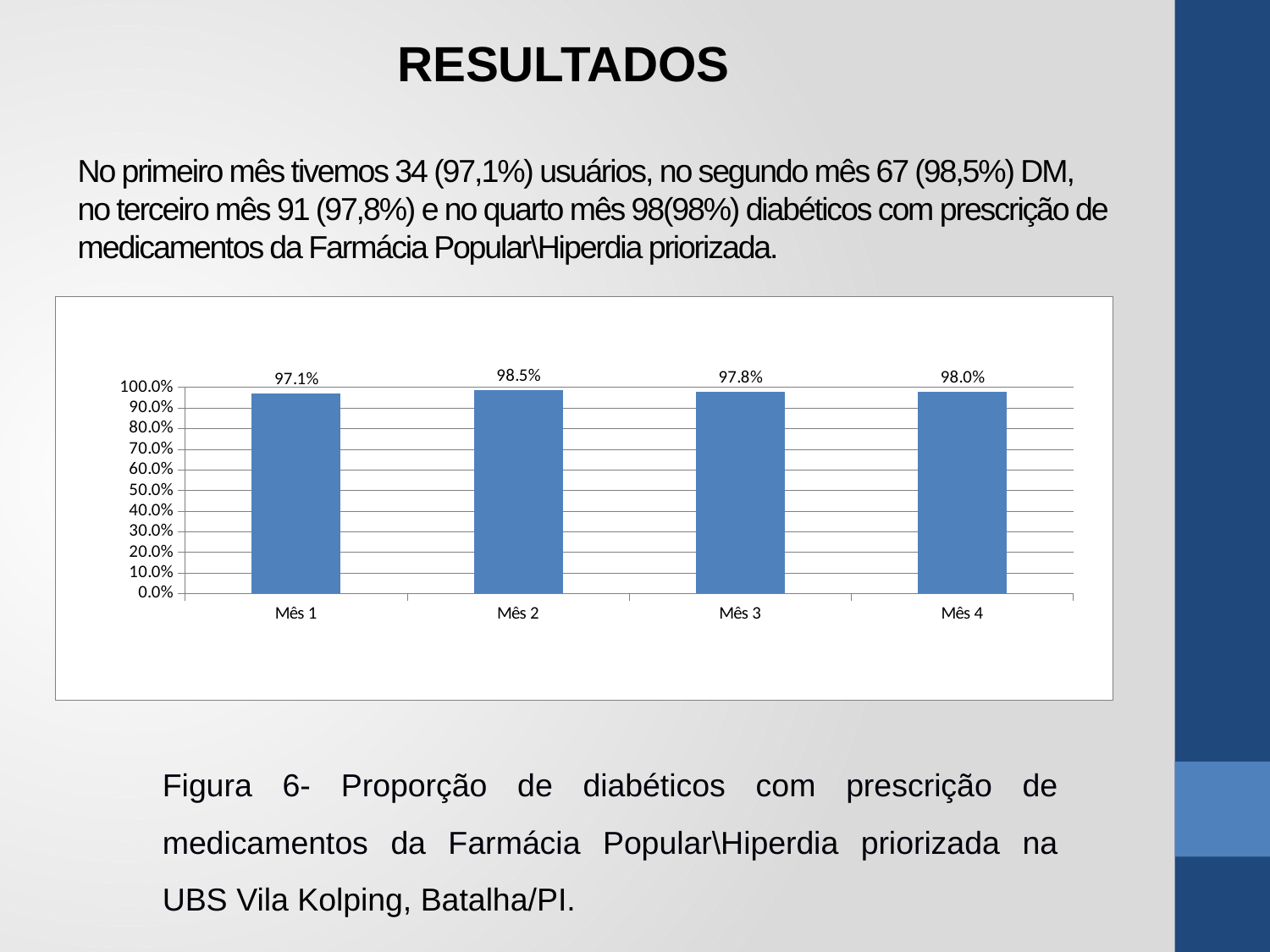
What is the value for Mês 4? 98.0% What is the value for Mês 3? 97.8% What is the value for Mês 1? 97.1% What is the difference between the values for Mês 2 and Mês 1? 1.4% Is the value for Mês 1 greater or less than 90.0%? greater What kind of chart is shown on the slide? bar chart What is the highest tick value shown on the y axis? 100.0% Which month has the highest value? Mês 2 Which is larger, the value for Mês 3 or the value for Mês 4? Mês 4 What is the value for Mês 2? 98.5% Which month has the lowest value? Mês 1 How many months are shown on the x axis? 4